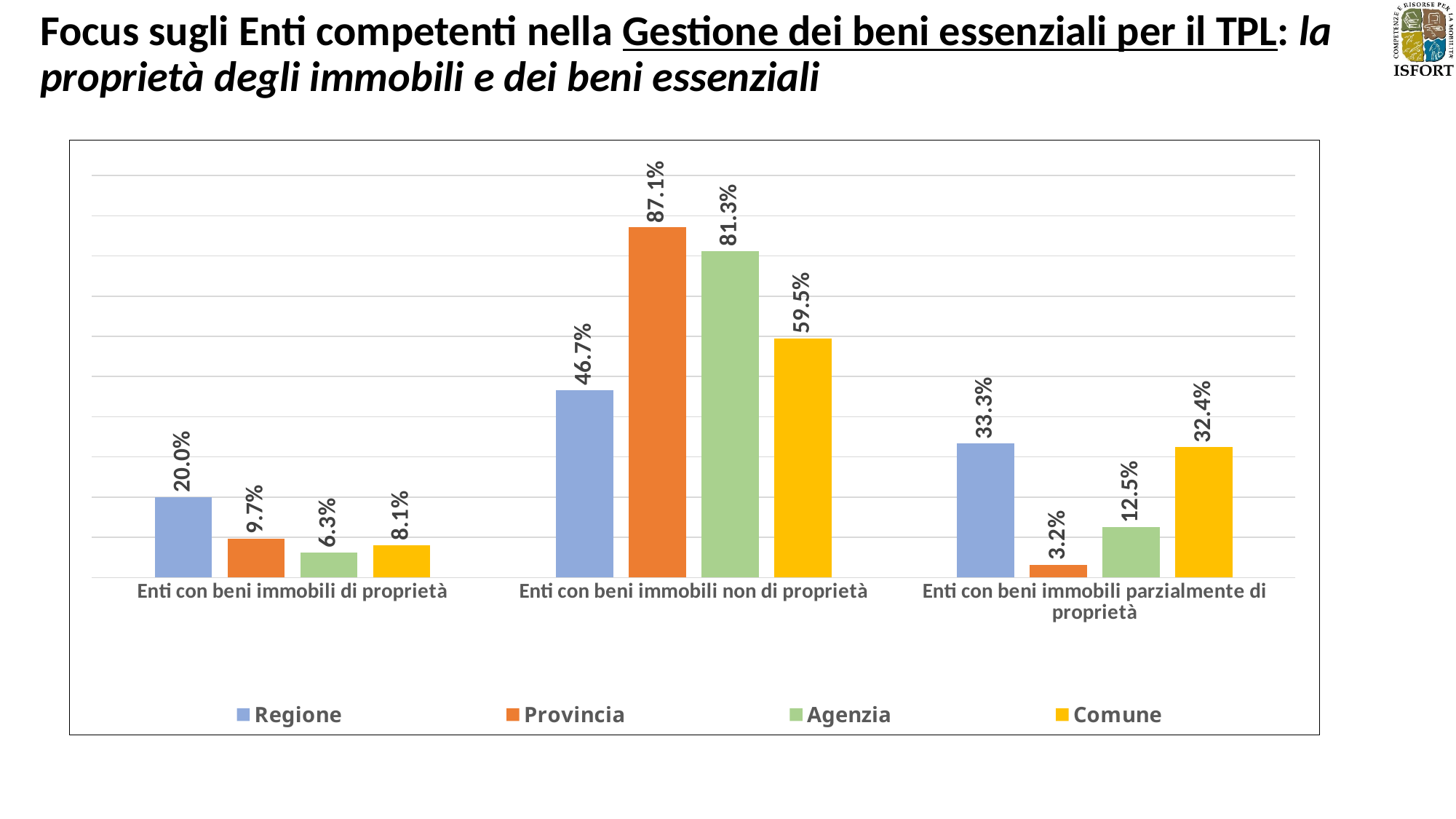
Which series is shown in orange in the legend? Provincia What is the difference between the Provincia and Comune values in the category 'Enti con beni immobili non di proprietà'? 27.6% Which series has the highest value in the category 'Enti con beni immobili non di proprietà'? Provincia Which is larger: the Regione value or the Comune value in the category 'Enti con beni immobili di proprietà'? Regione What kind of chart is shown on the slide? Bar chart What is the value for Provincia in the category 'Enti con beni immobili non di proprietà'? 87.1% What is the value for Comune in the category 'Enti con beni immobili parzialmente di proprietà'? 32.4% How many categories are shown on the x axis? 3 How many series does the legend list? 4 Which series has the lowest value in the category 'Enti con beni immobili parzialmente di proprietà'? Provincia What is the value for Agenzia in the category 'Enti con beni immobili non di proprietà'? 81.3% What is the value for Regione in the category 'Enti con beni immobili di proprietà'? 20.0%